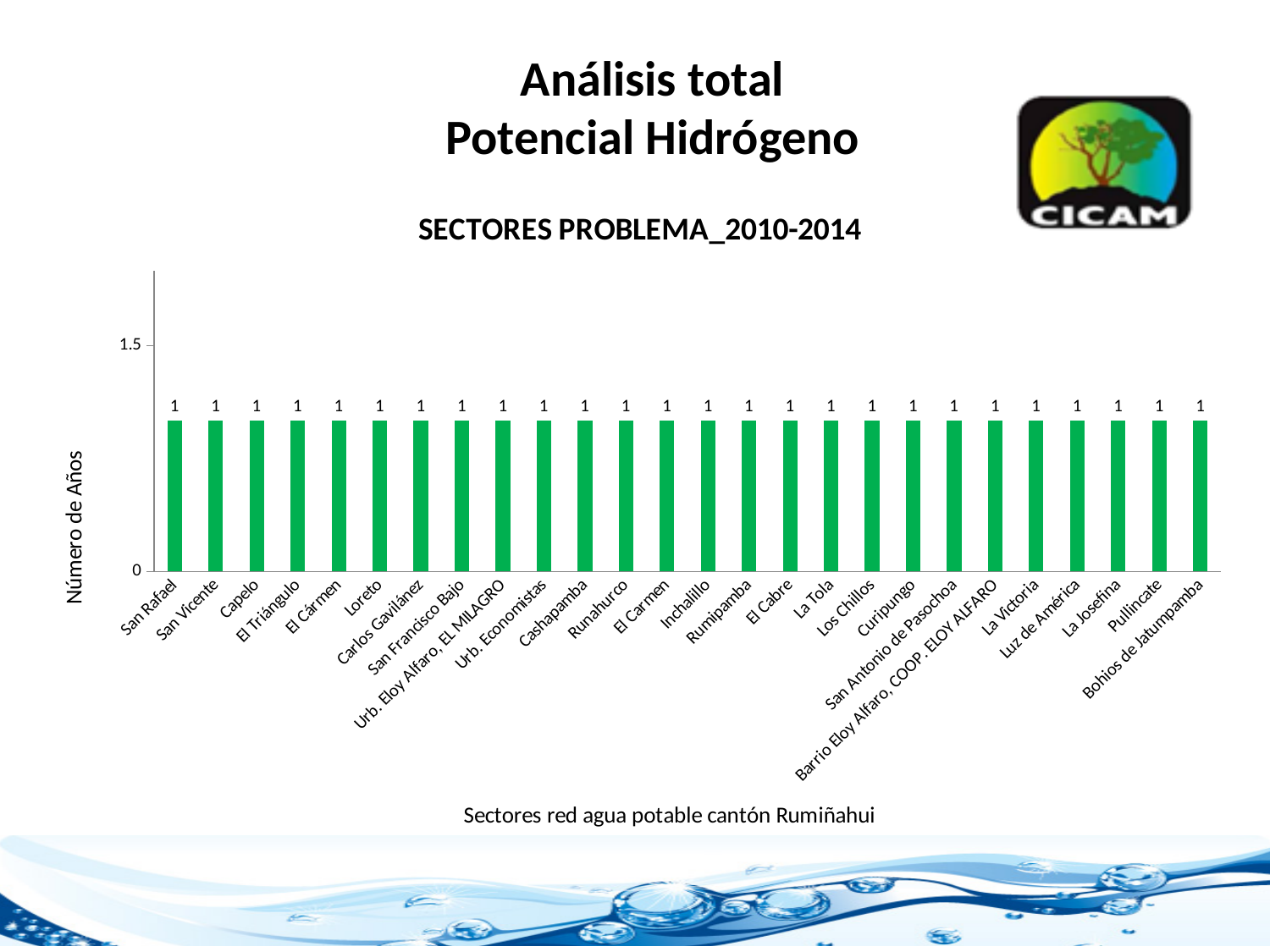
What is the value for Los Chillos? 1 How many sectors (categories) are plotted on the chart? 26 What is the difference between the values for Capelo and Pullincate? 0 What type of chart is shown on the slide? bar chart What is the label of the vertical axis? Número de Años Is the value for La Victoria greater or less than 1.5? less What is the value for San Rafael? 1 What is the title of the chart? SECTORES PROBLEMA_2010-2014 What is the value for Bohios de Jatumpamba? 1 Do the values rise, fall, or stay the same across the sectors along the x axis? stay the same What is the value for Cashapamba? 1